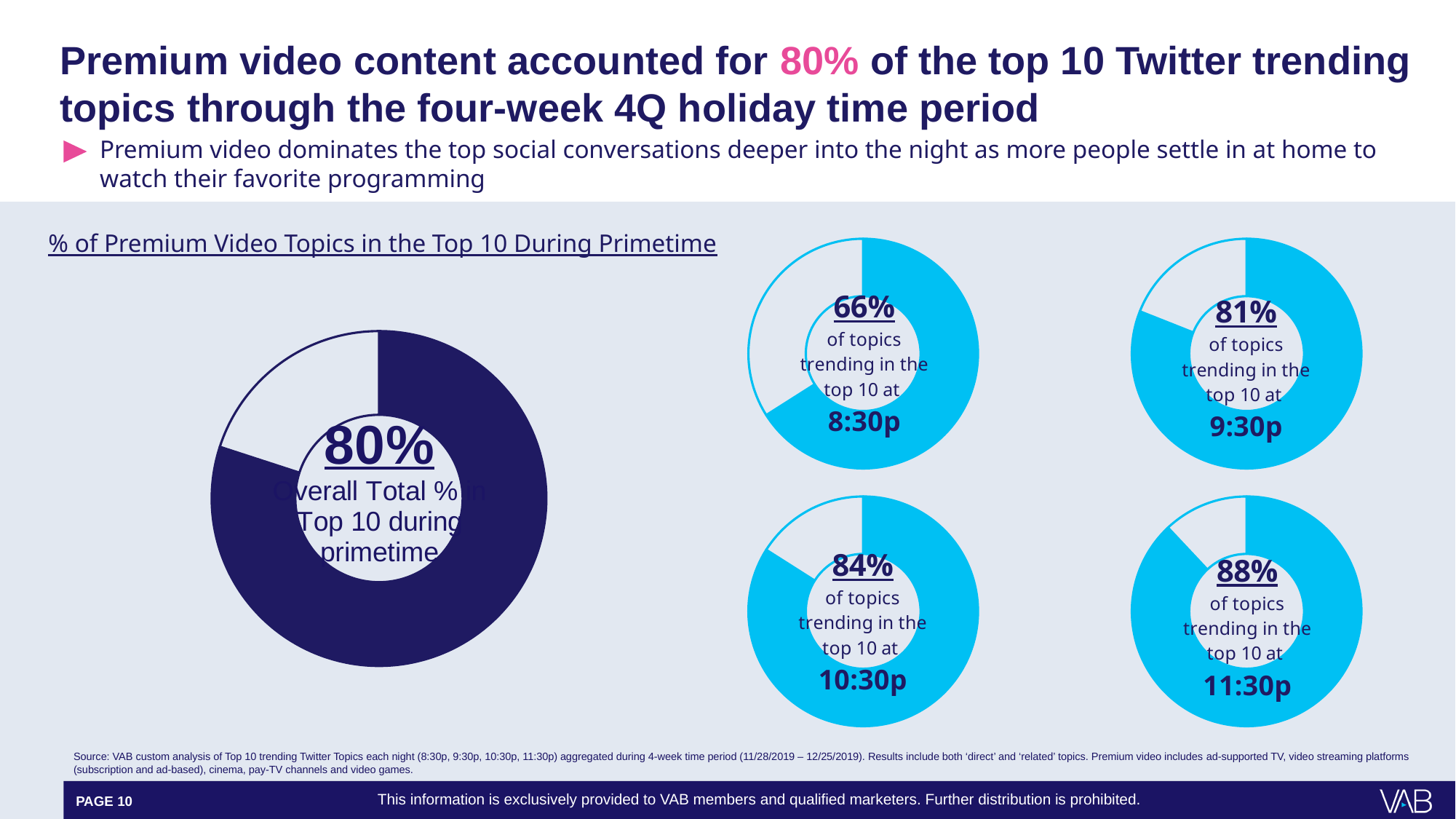
How many small time-slot donut charts are shown on the right side of the slide? 4 Across the four time-slot donut charts, does the percentage of premium video topics rise or fall as the time gets later? rise On the small donut chart for 10:30p, what percentage of topics trending in the top 10 were premium video? 84% What is the difference in percentage points between the 11:30p donut chart and the 8:30p donut chart? 22 Among the four time-slot donut charts, which time slot has the highest percentage of premium video topics in the top 10? 11:30p On the small donut chart for 11:30p, what percentage of topics trending in the top 10 were premium video? 88% On the small donut chart for 9:30p, what percentage of topics trending in the top 10 were premium video? 81% What type of chart is used to show the 80% overall total on the left of the slide? donut (pie) chart Among the four time-slot donut charts, which time slot has the lowest percentage of premium video topics in the top 10? 8:30p Which is larger: the percentage shown on the 9:30p donut chart or the percentage shown on the 10:30p donut chart? 10:30p On the large donut chart on the left, what is the overall total % of premium video topics in the top 10 during primetime? 80% On the small donut chart for 8:30p, what percentage of topics trending in the top 10 were premium video? 66%